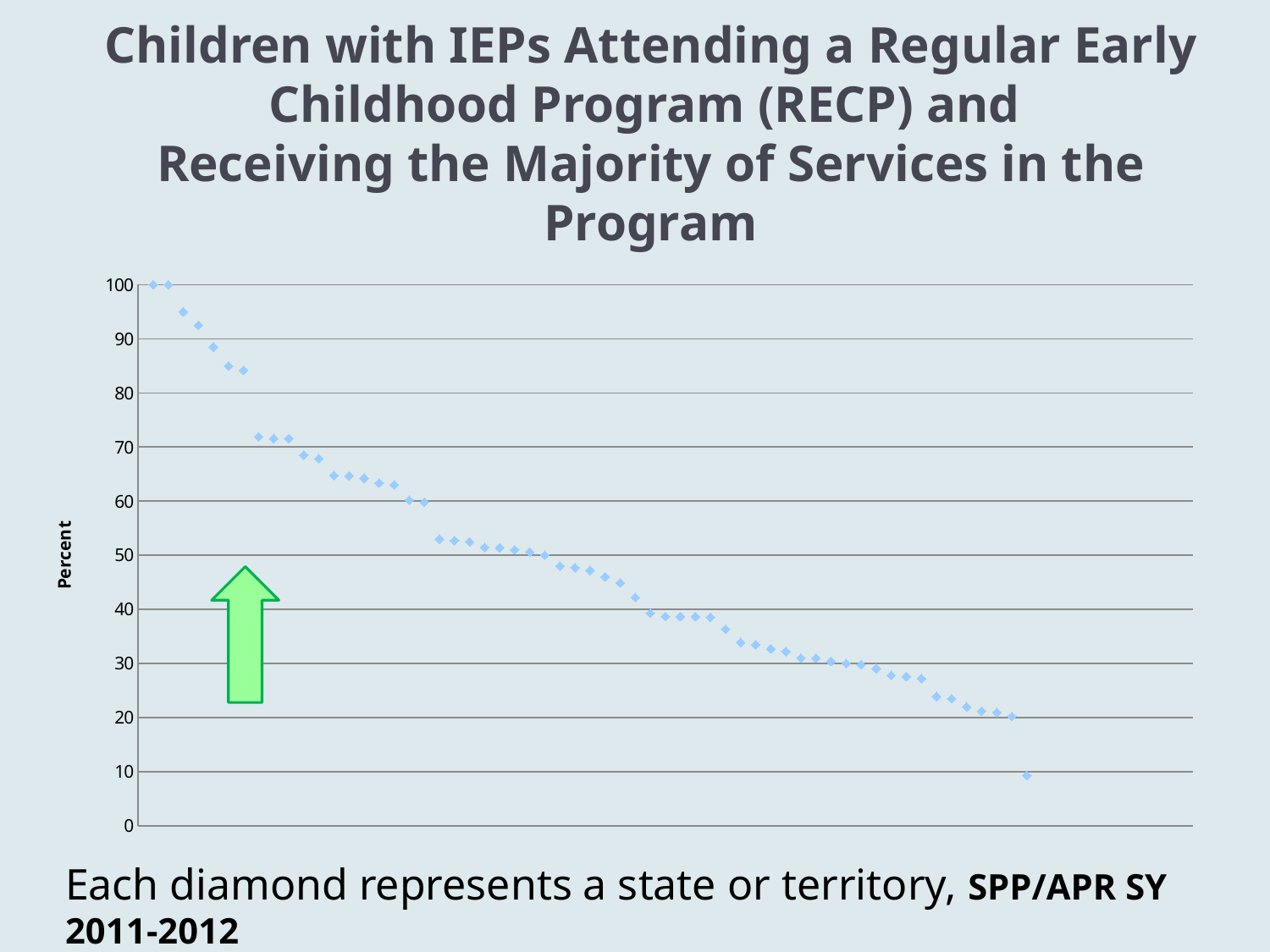
Do the plotted values rise or fall from left to right along the x axis? fall Which is larger, the value of the leftmost diamond or the value of the rightmost diamond? the leftmost diamond Is the value for the rightmost (lowest) diamond greater or less than 20? less What is the label on the vertical axis of the chart? Percent According to the slide, what does each diamond in the chart represent? a state or territory Is the value for the leftmost diamond greater or less than 90? greater What kind of chart is shown on the slide? scatter chart Is the value for the diamond immediately to the right of the green arrow greater or less than 60? greater